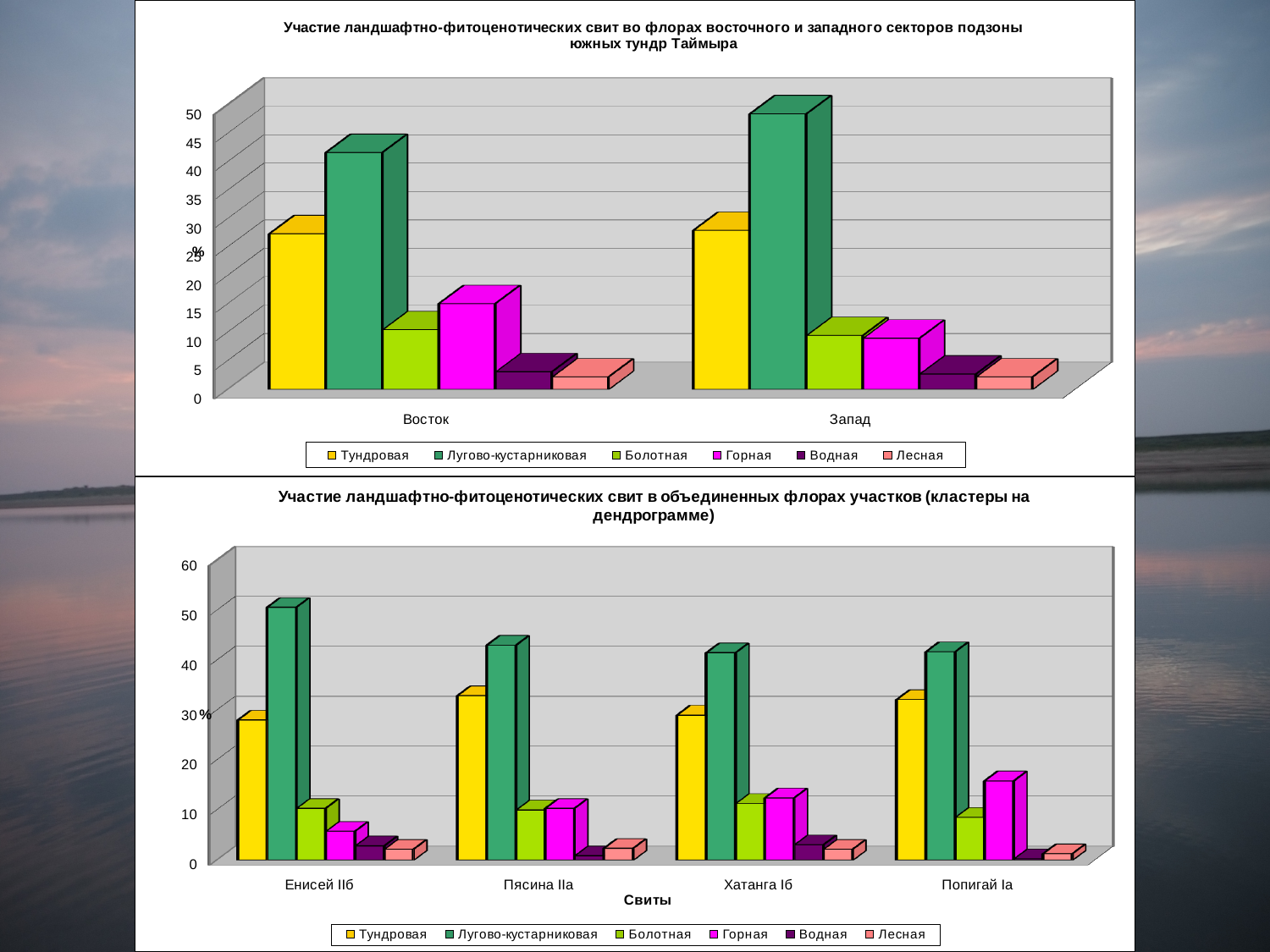
In the top chart, is the value of Горная for Восток greater or less than 10? greater In the bottom chart, is the value of Горная larger for Попигай Iа or for Енисей IIб? Попигай Iа In the top chart, which series has the highest value for Запад? Лугово-кустарниковая What kind of chart is the top chart titled 'Участие ландшафтно-фитоценотических свит во флорах восточного и западного секторов подзоны южных тундр Таймыра'? bar chart In the bottom chart, how many categories are shown on the x axis? 4 In the top chart, is the value of Лугово-кустарниковая larger for Восток or for Запад? Запад What is the x-axis title of the bottom chart? Свиты In the top chart, how many series does the legend list? 6 In the top chart, is the value of Лугово-кустарниковая for Восток greater or less than 35? greater In the bottom chart, is the value of Тундровая for Пясина IIа greater or less than 20? greater In the bottom chart, which category has the highest value for Лугово-кустарниковая? Енисей IIб In the top chart, how many categories are shown on the x axis? 2